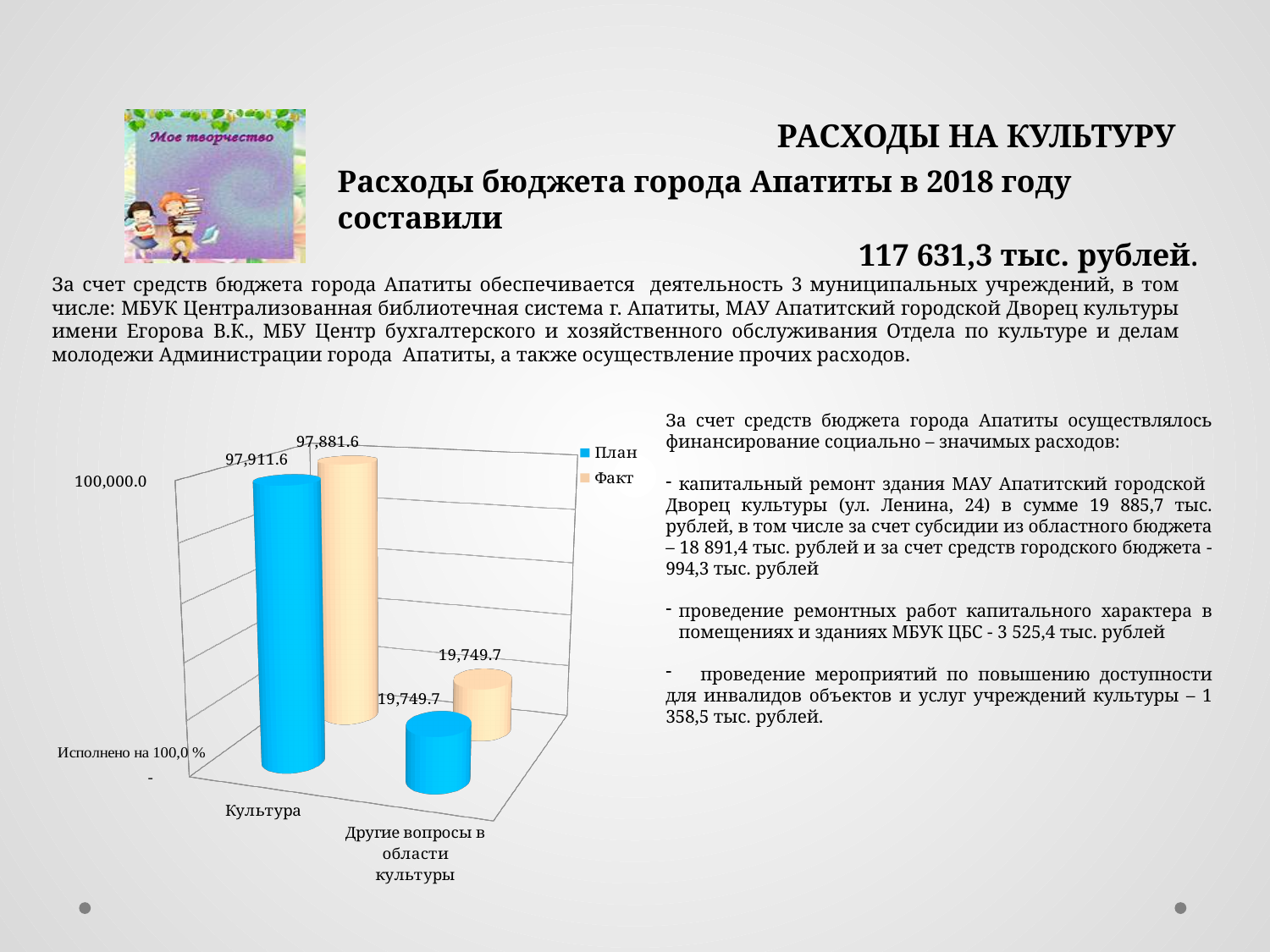
How many series does the chart legend list? 2 What is the difference between the План and Факт values for Культура? 30.0 What are the two series named in the chart legend? План and Факт Which category has the lowest Факт value? Другие вопросы в области культуры How many categories are shown on the x axis of the chart? 2 What kind of chart is shown on the slide? bar chart What is the Факт value for Другие вопросы в области культуры? 19,749.7 What is the Факт value for Культура? 97,881.6 What is the План value for Другие вопросы в области культуры? 19,749.7 What is the План value for Культура? 97,911.6 Is the План value for Культура greater or less than 100,000.0? less Which category has the higher План value, Культура or Другие вопросы в области культуры? Культура